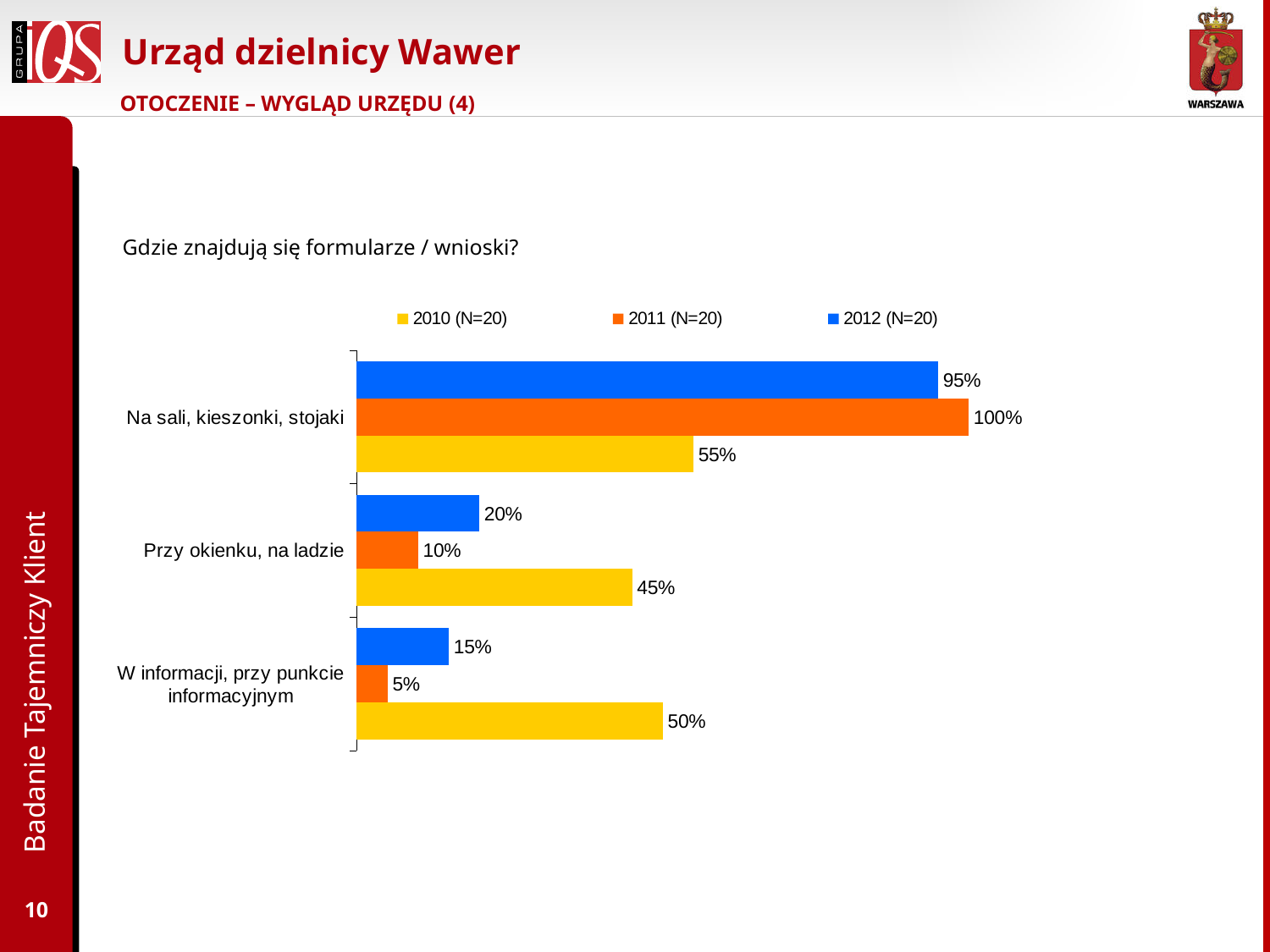
Which category has the highest value in the 2011 (N=20) series? Na sali, kieszonki, stojaki What is the value for "W informacji, przy punkcie informacyjnym" in the 2011 (N=20) series? 5% How many categories are shown on the chart? 3 Which colour represents the 2011 (N=20) series? Orange What is the difference between the 2011 (N=20) and 2010 (N=20) values for "Na sali, kieszonki, stojaki"? 45% Which is larger for "Przy okienku, na ladzie": the 2010 (N=20) value or the 2012 (N=20) value? 2010 (N=20) What kind of chart is shown on the slide? Bar chart What is the value for "Na sali, kieszonki, stojaki" in the 2012 (N=20) series? 95% What question is the chart answering, as stated above it? Gdzie znajdują się formularze / wnioski? What is the value for "Przy okienku, na ladzie" in the 2010 (N=20) series? 45% How many series does the legend list? 3 Which category has the lowest value in the 2012 (N=20) series? W informacji, przy punkcie informacyjnym